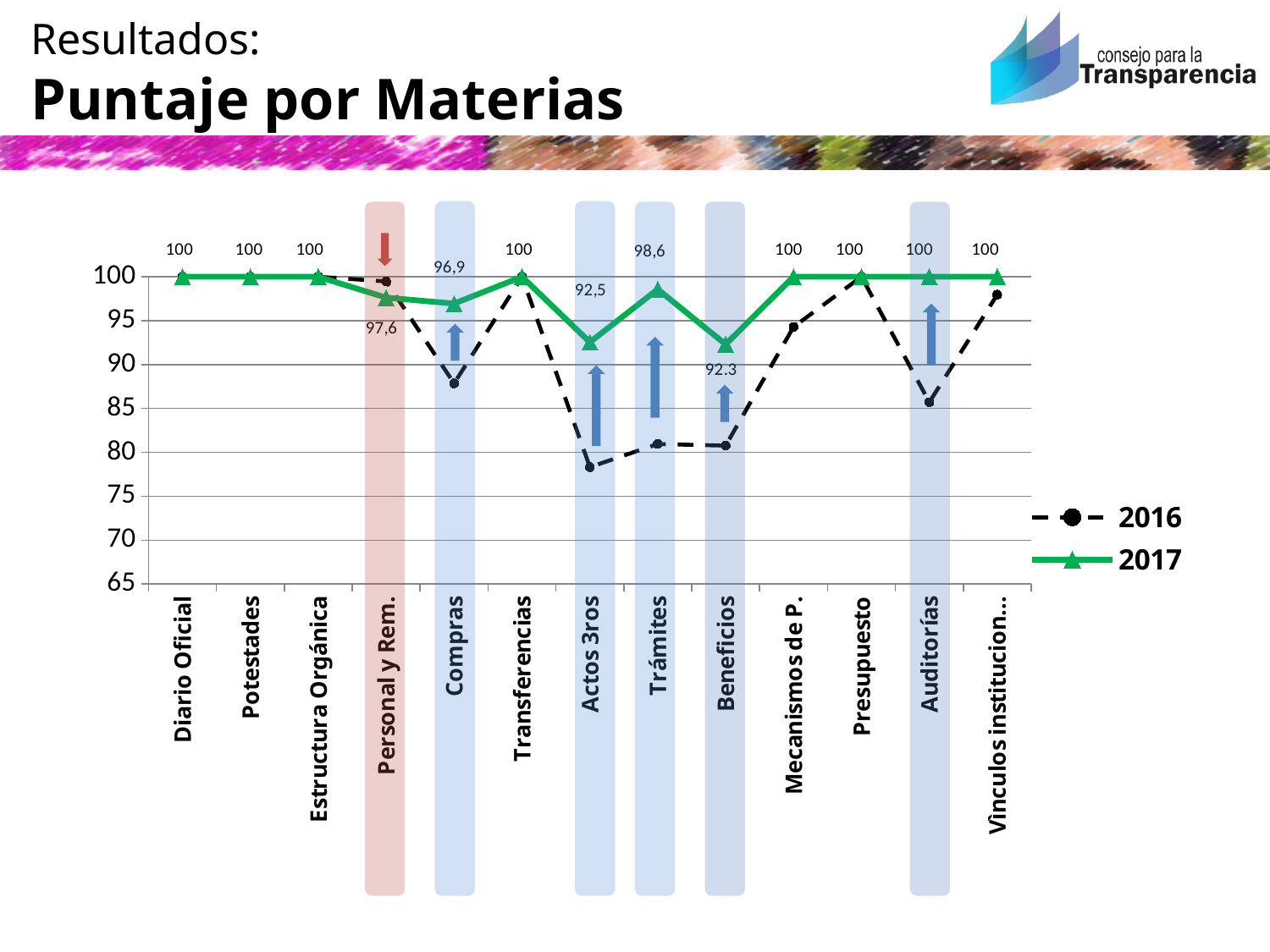
How many categories are plotted along the x axis? 13 Is the 2016 value for Actos 3ros greater or less than 80? less What kind of chart is shown on the slide? line chart For Actos 3ros, which series has the larger value, 2016 or 2017? 2017 What is the 2017 value for Compras? 96,9 Is the 2016 value for Auditorías greater or less than 90? less What are the two entries listed in the legend? 2016 and 2017 What is the 2017 value for Actos 3ros? 92,5 Is the 2016 value for Compras greater or less than 90? less What is the 2017 value for Trámites? 98,6 What is the 2017 value for Personal y Rem.? 97,6 How many series does the legend list? 2